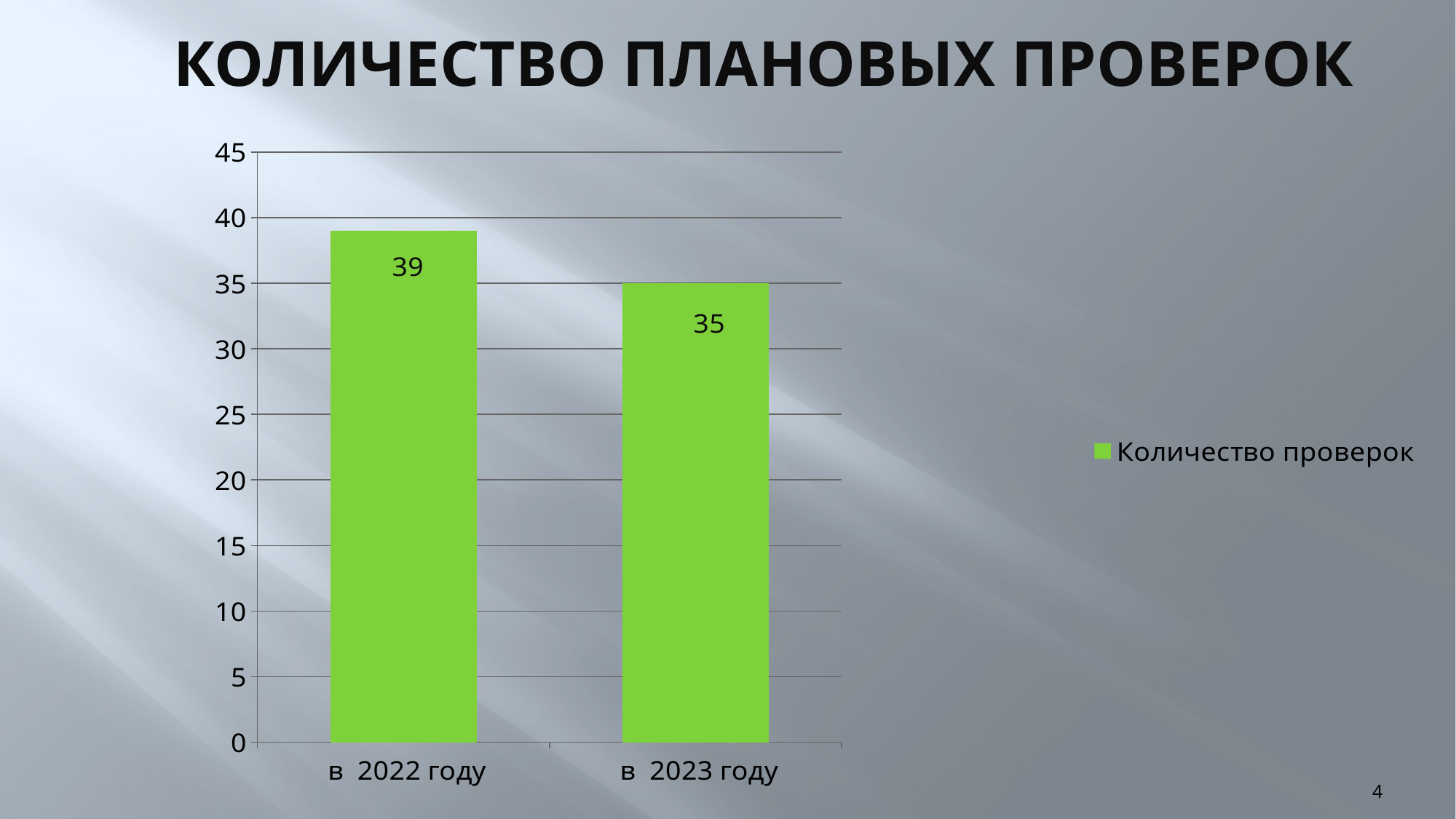
Which category has the highest value? в 2022 году How many categories are shown on the x axis? 2 Do the values rise or fall from 2022 to 2023? fall Which is larger, the value for "в 2022 году" or "в 2023 году"? в 2022 году What is the difference between the values for "в 2022 году" and "в 2023 году"? 4 Which category has the lowest value? в 2023 году What kind of chart is shown on the slide? bar chart What is the value for "в 2023 году"? 35 What is the title of the slide? КОЛИЧЕСТВО ПЛАНОВЫХ ПРОВЕРОК How many series does the legend list? 1 Is the value for "в 2023 году" greater or less than 40? less What is the value for "в 2022 году"? 39